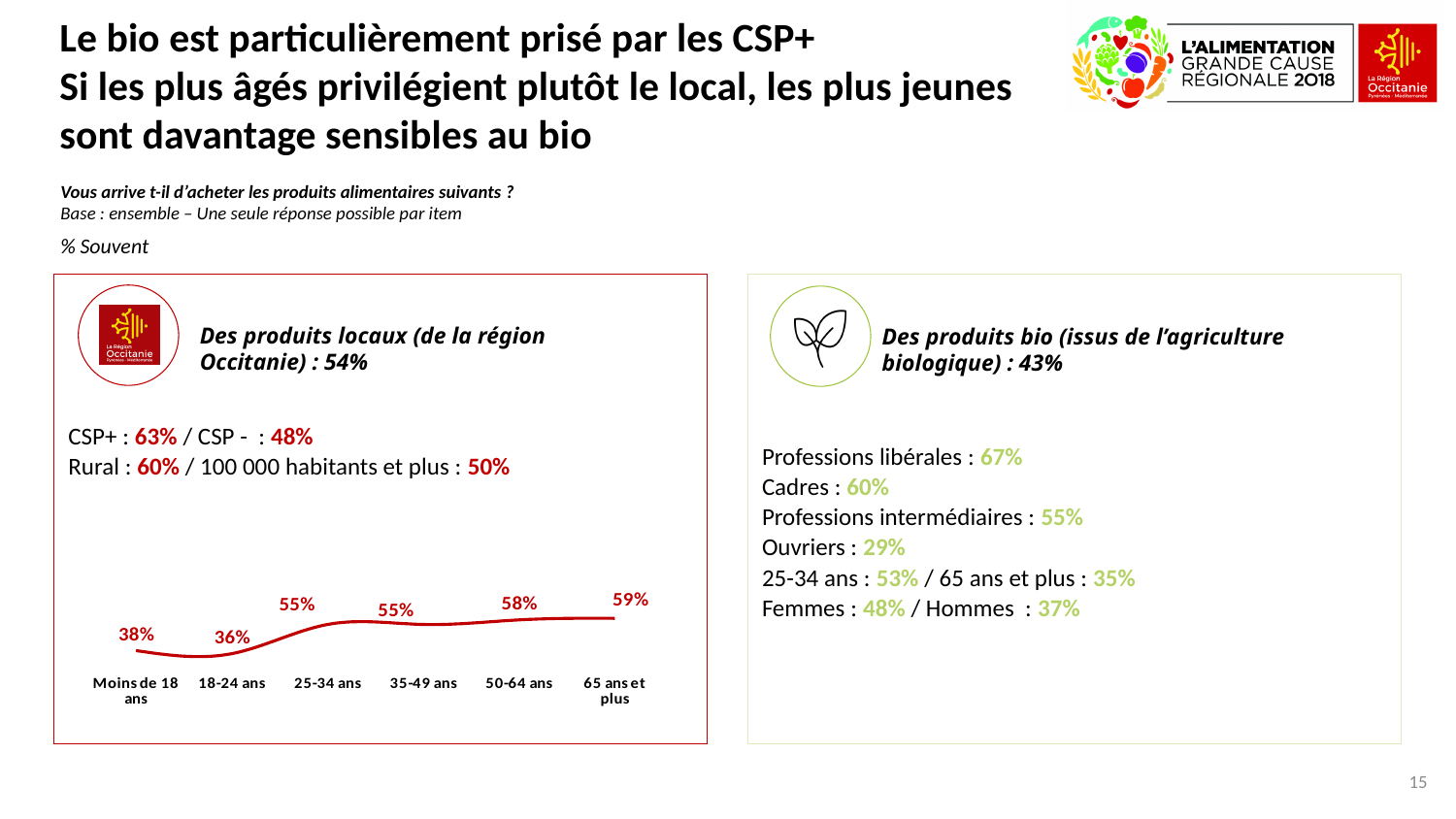
Which age group has the highest value on the line chart? 65 ans et plus How many age groups are plotted on the line chart? 6 What kind of chart is shown in the left box about local products? line chart Which age group has the lowest value on the line chart? 18-24 ans What is the difference between the values for '65 ans et plus' and '18-24 ans' on the line chart? 23% What is the value for 'Moins de 18 ans' on the line chart? 38% What is the value for '50-64 ans' on the line chart? 58% Which is larger on the line chart: the value for '50-64 ans' or the value for '35-49 ans'? 50-64 ans Do the values on the line chart generally rise or fall from the youngest to the oldest age group? rise What colour is the line on the line chart? red What is the value for '25-34 ans' on the line chart? 55% What is the value for '18-24 ans' on the line chart? 36%